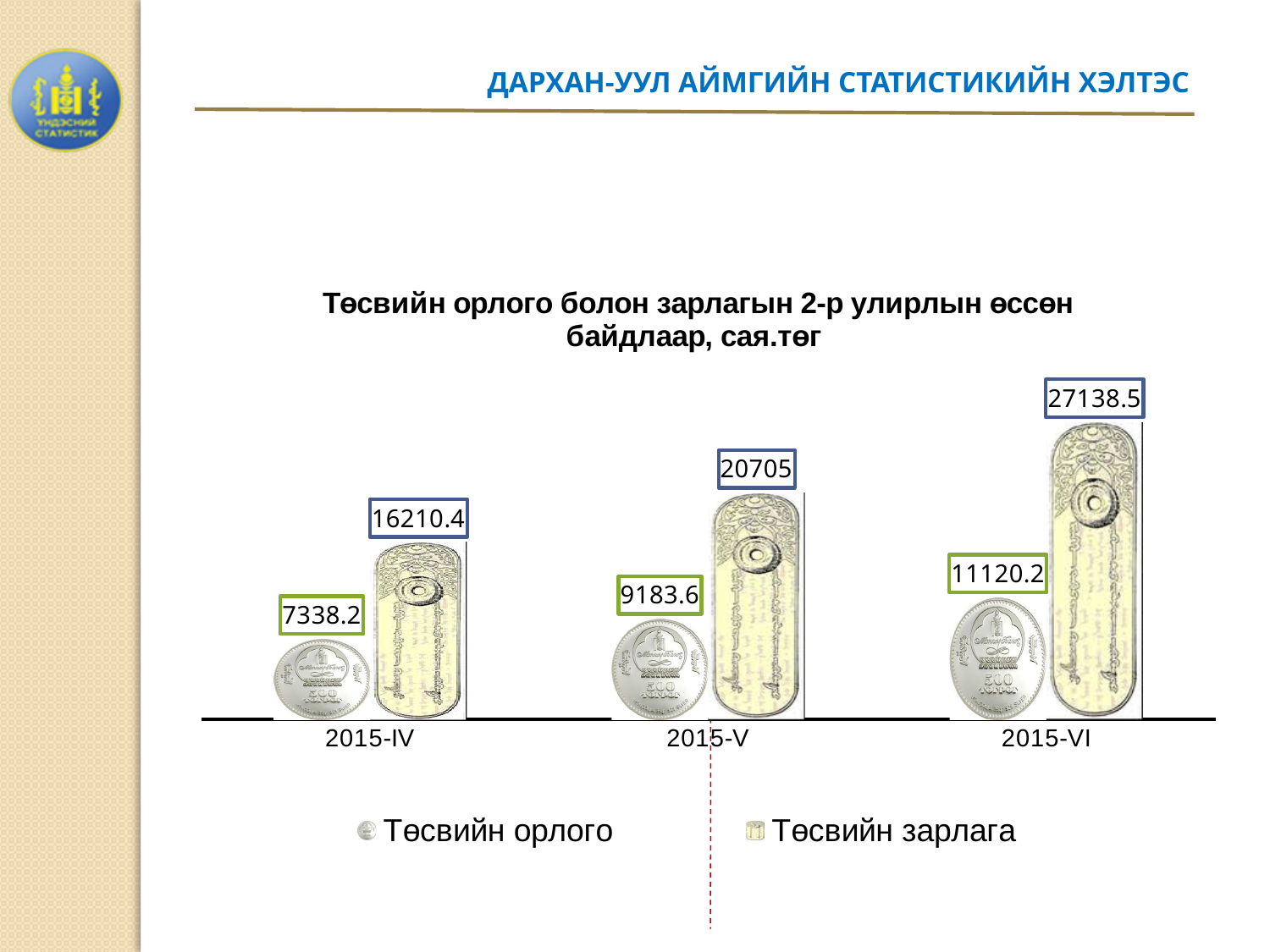
What kind of chart is shown on the slide? Bar chart Which is larger for 2015-V: Төсвийн орлого or Төсвийн зарлага? Төсвийн зарлага What is the value of Төсвийн орлого for 2015-VI? 11120.2 Do the values for Төсвийн орлого rise or fall from 2015-IV to 2015-VI? Rise What is the difference between Төсвийн зарлага and Төсвийн орлого for 2015-IV? 8872.2 What is the value of Төсвийн орлого for 2015-IV? 7338.2 What is the value of Төсвийн зарлага for 2015-VI? 27138.5 What is the value of Төсвийн зарлага for 2015-V? 20705 How many series does the legend list? 2 Which category has the highest value for Төсвийн зарлага? 2015-VI Which category has the lowest value for Төсвийн орлого? 2015-IV How many categories are shown on the x axis? 3